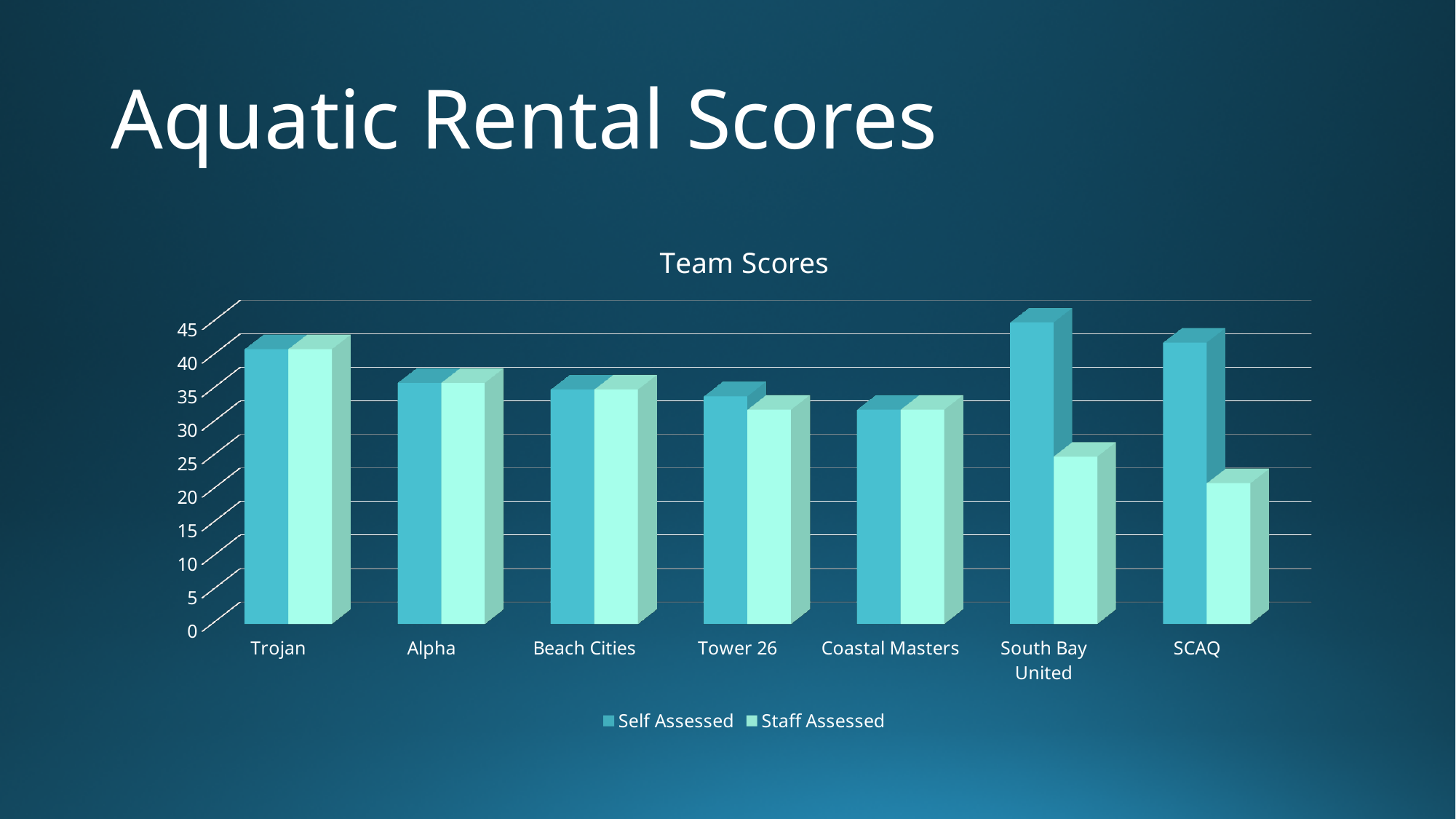
Which team has the lowest Staff Assessed score? SCAQ Which team has the highest Self Assessed score? South Bay United What is the title of the chart? Team Scores What kind of chart is shown on the slide? bar chart Is the Staff Assessed score for SCAQ greater or less than 30? less How many series does the legend list? 2 Which team has the highest Staff Assessed score? Trojan For South Bay United, which is larger: the Self Assessed score or the Staff Assessed score? Self Assessed How many teams are shown on the x axis of the chart? 7 What are the two series named in the legend? Self Assessed and Staff Assessed Is the Self Assessed score for South Bay United greater or less than 40? greater Is the Self Assessed score for Coastal Masters greater or less than 40? less